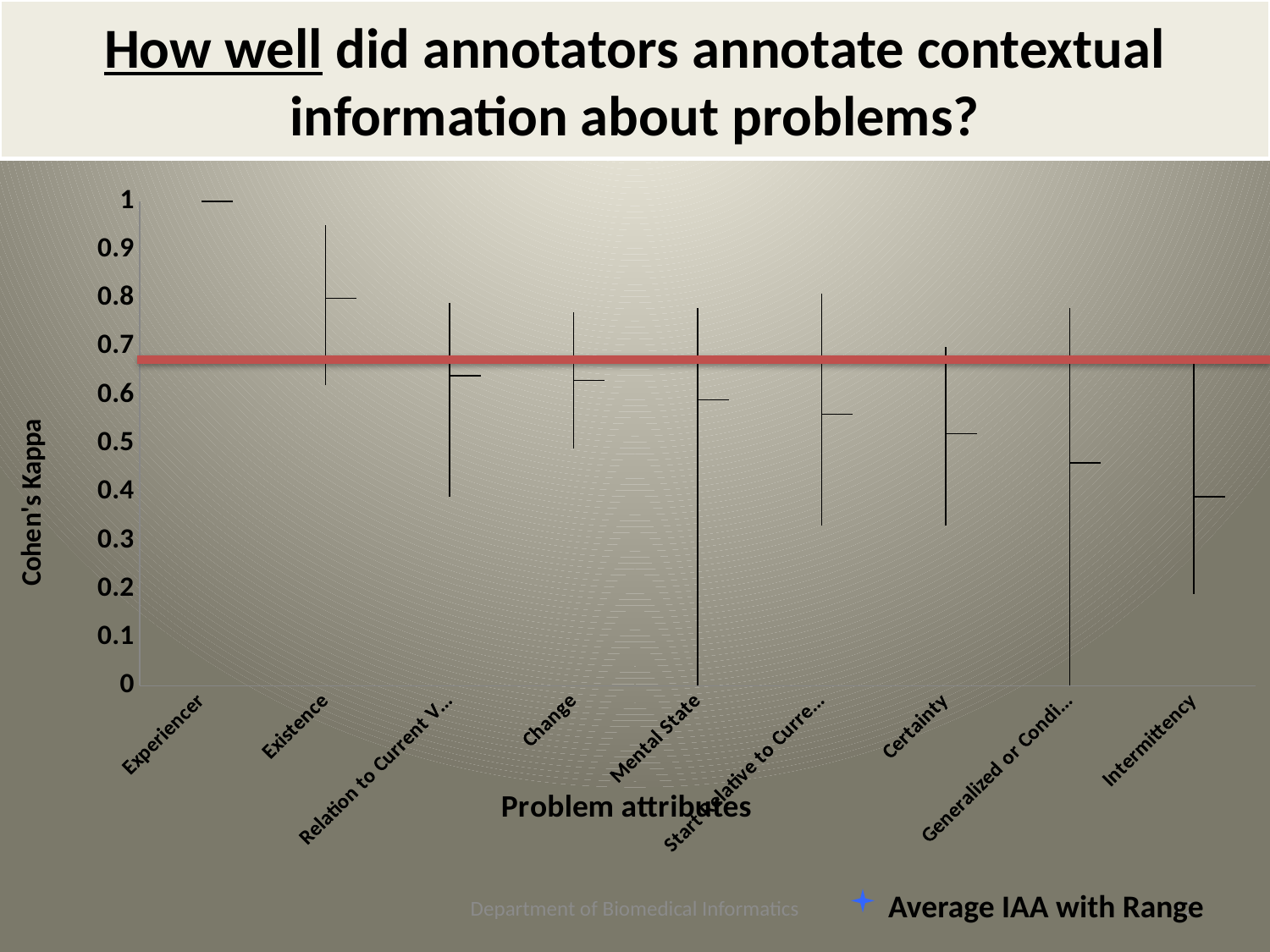
What is the average Cohen's Kappa value for Experiencer? 1 Which has a higher average Cohen's Kappa, Change or Start relative to Current? Change Which problem attribute has the lowest average Cohen's Kappa on the chart? Intermittency Is the average Cohen's Kappa for Intermittency greater or less than 0.5? less Which has a higher average Cohen's Kappa, Existence or Change? Existence What is the title of the horizontal axis on the chart? Problem attributes Is the average Cohen's Kappa for Existence greater or less than 0.7? greater Is the average Cohen's Kappa for Certainty greater or less than 0.6? less How many problem attributes are plotted along the x axis of the chart? 9 Which problem attribute has the highest average Cohen's Kappa on the chart? Experiencer What is the title of the vertical axis on the chart? Cohen's Kappa